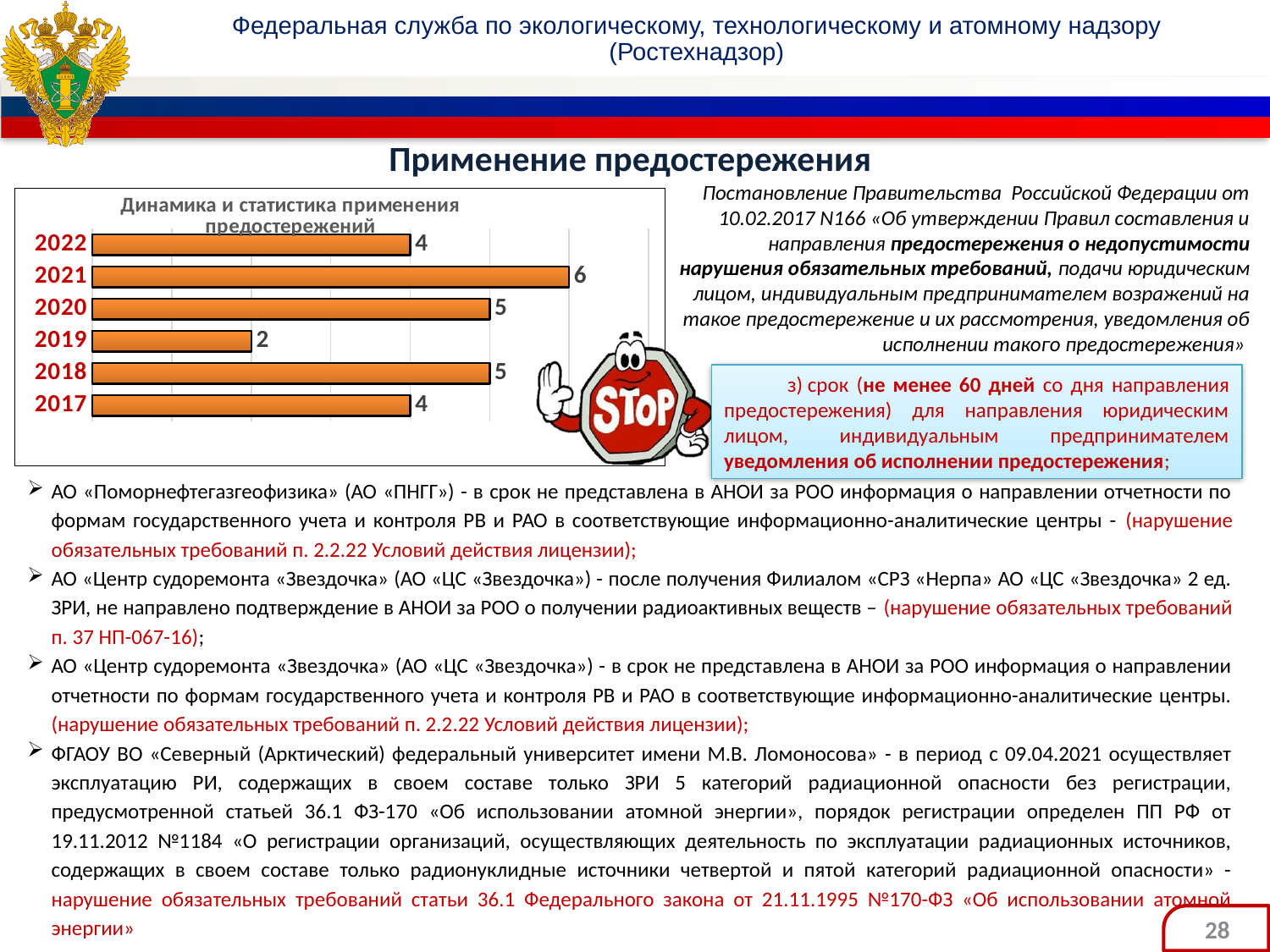
Which is larger, the value for 2018 or the value for 2019? 2018 What is the title of the chart? Динамика и статистика применения предостережений What is the difference between the values for 2020 and 2022? 1 What kind of chart is shown on the slide? Bar chart How many years are shown in the chart? 6 What is the value for 2019 in the chart? 2 Which year has the lowest value in the chart? 2019 Do the values for 2017 and 2022 match? Yes, both are 4 What is the value for 2021 in the chart? 6 What is the value for 2022 in the chart? 4 What is the difference between the values for 2021 and 2019? 4 Which year has the highest value in the chart? 2021